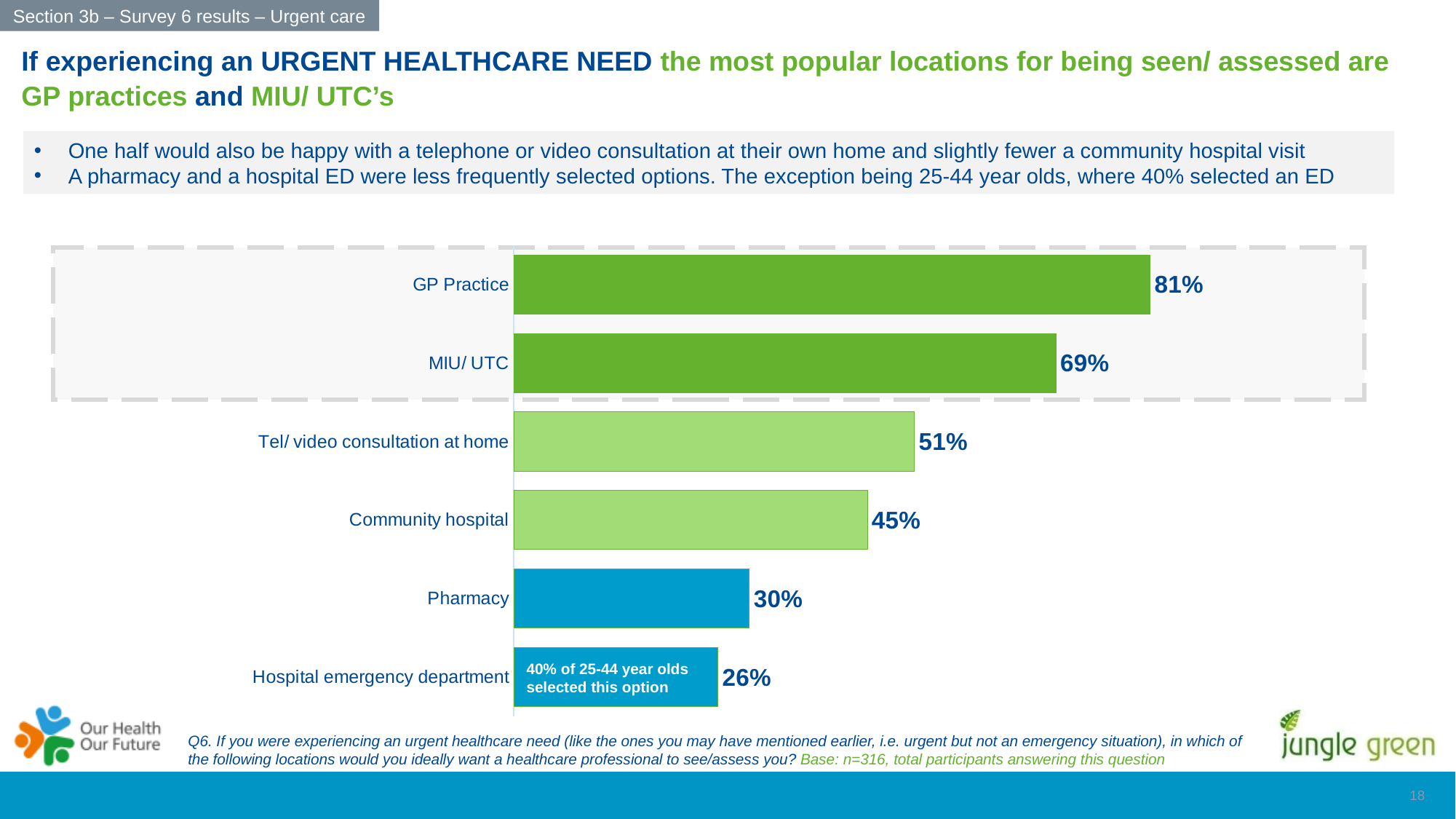
What percentage selected Tel/ video consultation at home? 51% What type of chart is shown on the slide? Bar chart Which location has the highest percentage in the chart? GP Practice Which location has the lowest percentage in the chart? Hospital emergency department How many locations are shown in the chart? 6 Which has a higher value, Tel/ video consultation at home or Community hospital? Tel/ video consultation at home What is the value shown for MIU/ UTC? 69% What is the value for Hospital emergency department? 26% According to the label on the Hospital emergency department bar, what percentage of 25-44 year olds selected this option? 40% What is the difference in percentage points between Community hospital and Pharmacy? 15 What is the difference in percentage points between GP Practice and MIU/ UTC? 12 What percentage of respondents selected GP Practice as a location for being seen for an urgent healthcare need? 81%